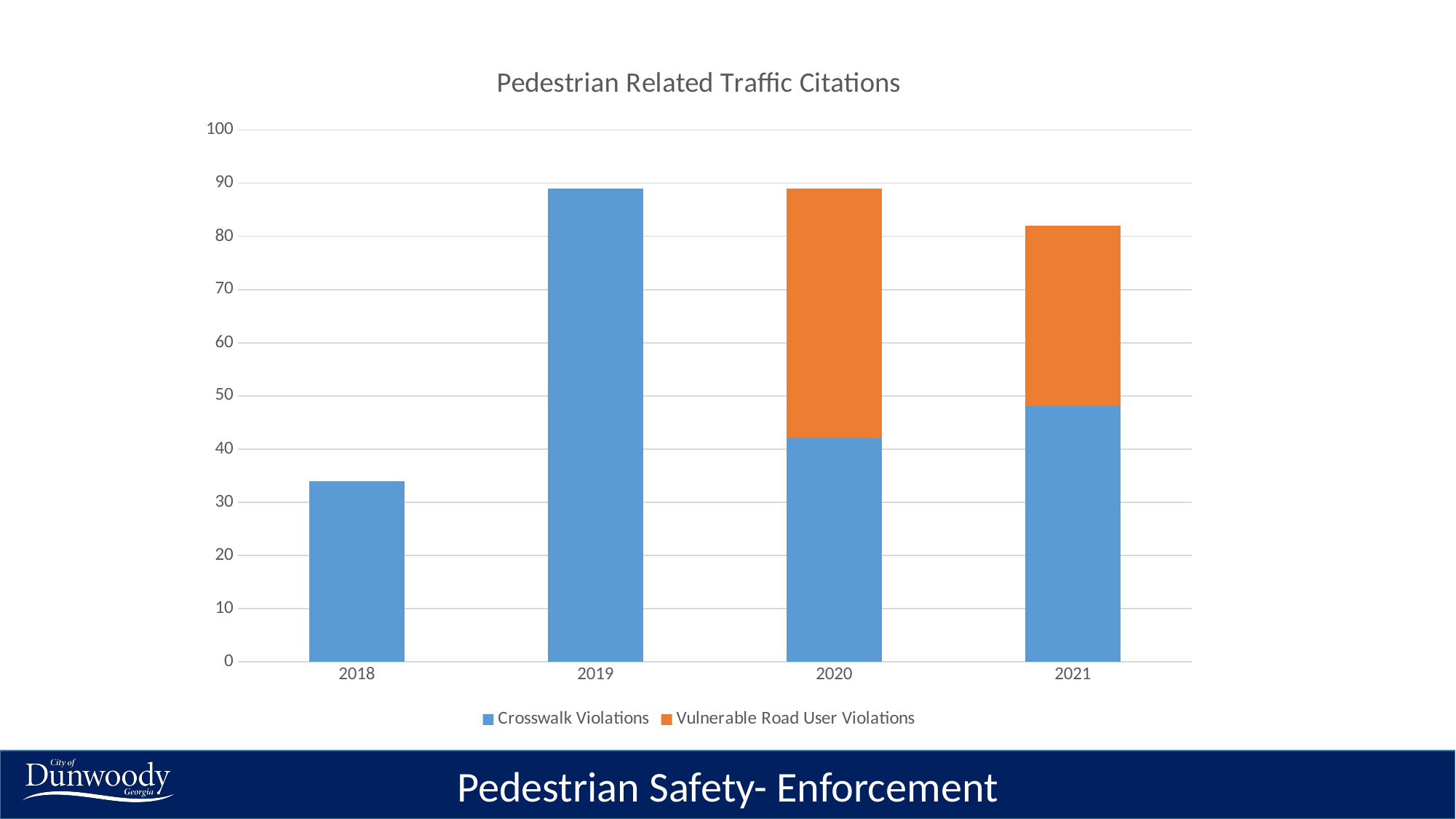
Is the value for Crosswalk Violations in 2020 greater or less than 50? less How many years are shown on the x axis? 4 How many series does the legend list? 2 Which is larger: the total citations in 2018 or in 2021? 2021 What type of chart is shown on the slide? Stacked bar chart Which year has the highest number of Crosswalk Violations? 2019 Which series is shown in orange? Vulnerable Road User Violations What is the title of the chart? Pedestrian Related Traffic Citations Is the value for Crosswalk Violations in 2018 greater or less than 30? greater Which year has the lowest total number of citations? 2018 Is the value for Crosswalk Violations in 2019 greater or less than 80? greater